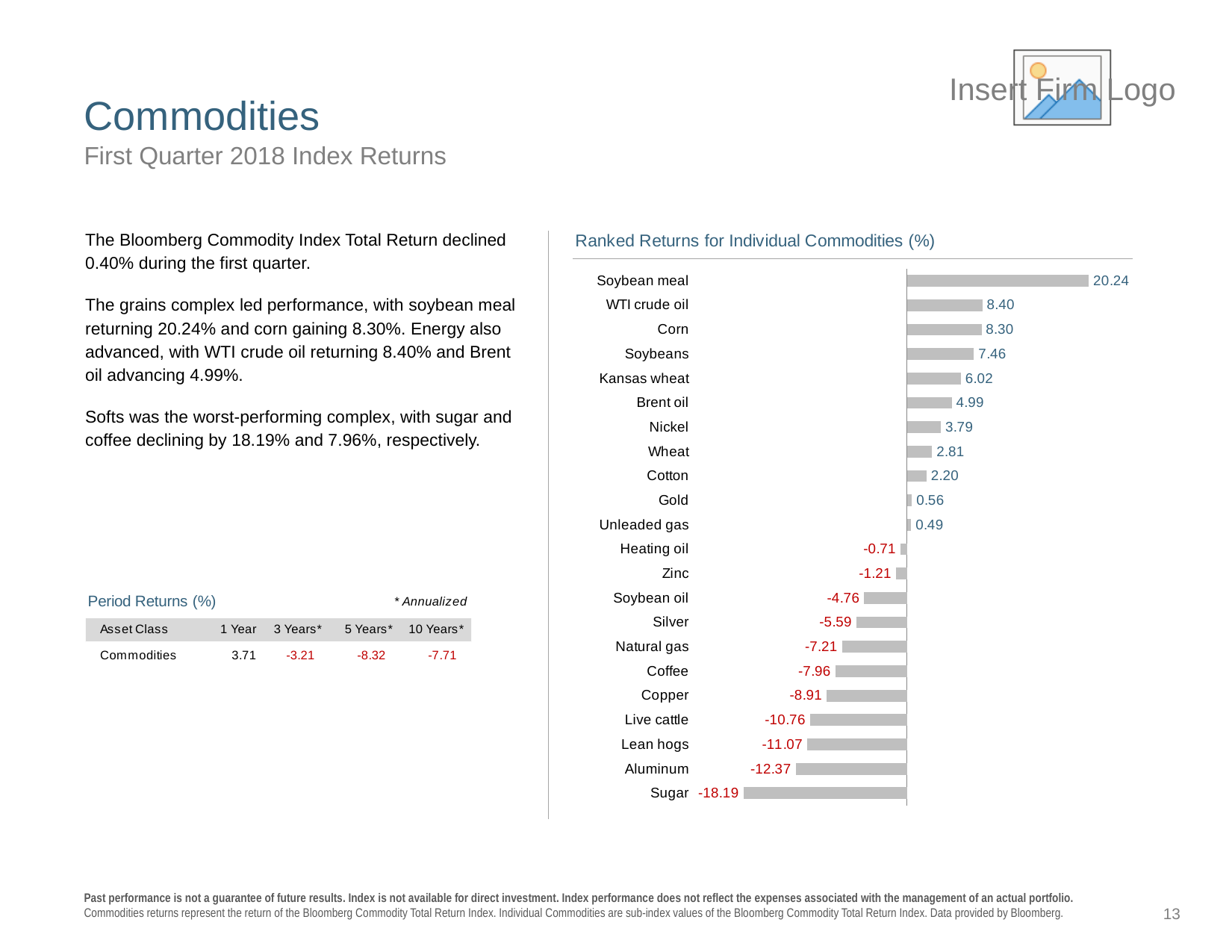
Which has a higher return in the Ranked Returns for Individual Commodities chart, Nickel or Wheat? Nickel What is the return for Sugar in the Ranked Returns for Individual Commodities chart? -18.19 What type of chart is the Ranked Returns for Individual Commodities chart? Bar chart What is the return for Brent oil in the Ranked Returns for Individual Commodities chart? 4.99 What is the return for Soybean meal in the Ranked Returns for Individual Commodities chart? 20.24 What is the difference between the returns for WTI crude oil and Corn in the Ranked Returns for Individual Commodities chart? 0.10 What is the difference between the returns for Soybean meal and Soybeans in the Ranked Returns for Individual Commodities chart? 12.78 Which commodity has the lowest return in the Ranked Returns for Individual Commodities chart? Sugar What is the return for Natural gas in the Ranked Returns for Individual Commodities chart? -7.21 How many commodities are shown in the Ranked Returns for Individual Commodities chart? 22 Which commodity has the highest return in the Ranked Returns for Individual Commodities chart? Soybean meal Which has a lower return in the Ranked Returns for Individual Commodities chart, Copper or Aluminum? Aluminum